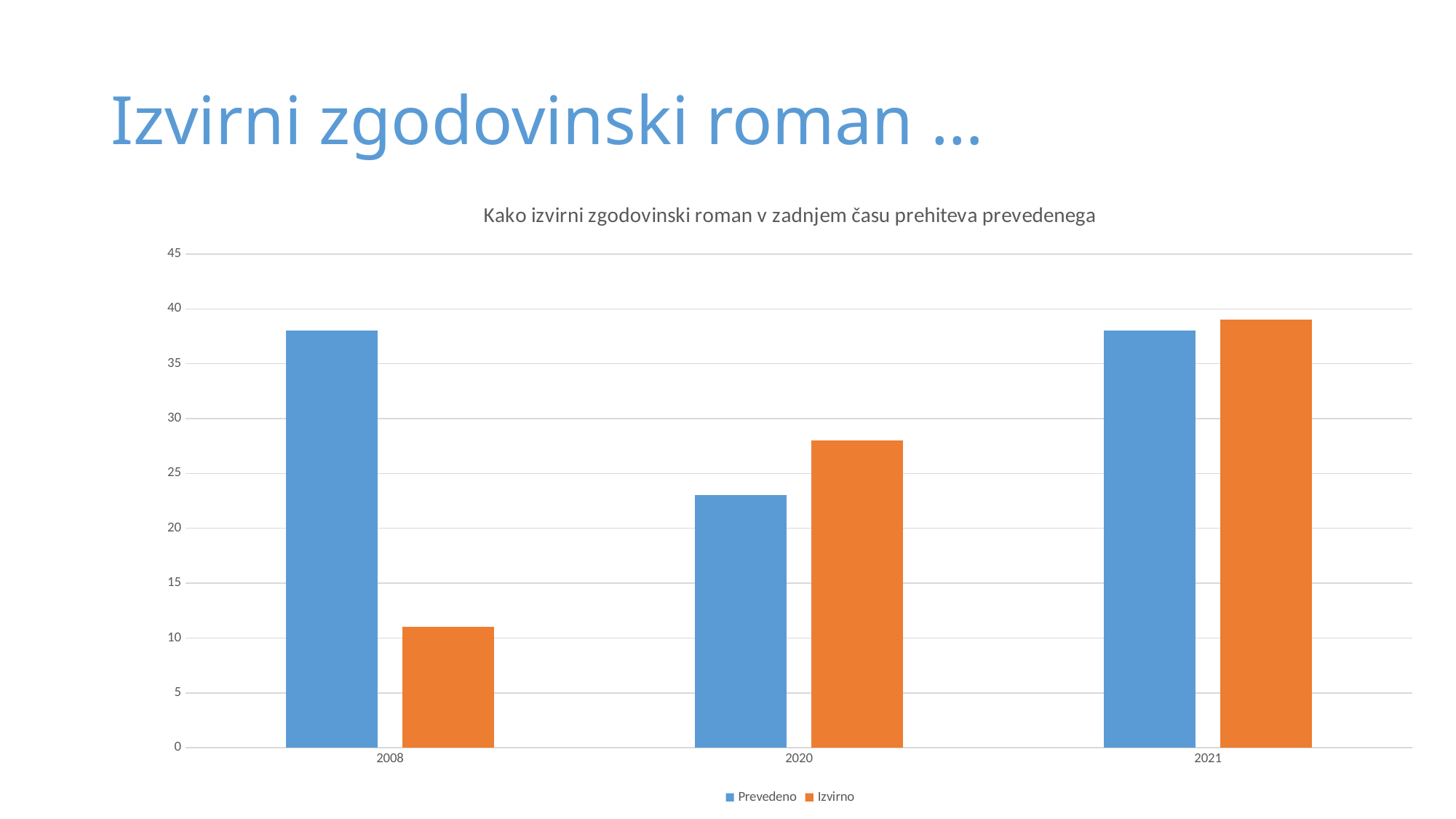
Is the value for Izvirno in 2008 greater or less than 15? less In which year is the value for Prevedeno lowest? 2020 What is the title of the chart? Kako izvirni zgodovinski roman v zadnjem času prehiteva prevedenega Do the values for Izvirno rise or fall from 2008 to 2021? rise Which series is shown in orange? Izvirno In 2008, which is larger, Prevedeno or Izvirno? Prevedeno In which year is the value for Izvirno highest? 2021 How many series does the legend list? 2 How many years are shown on the x axis? 3 In which year is the value for Izvirno lowest? 2008 What kind of chart is shown on the slide? bar chart In 2020, which is larger, Prevedeno or Izvirno? Izvirno